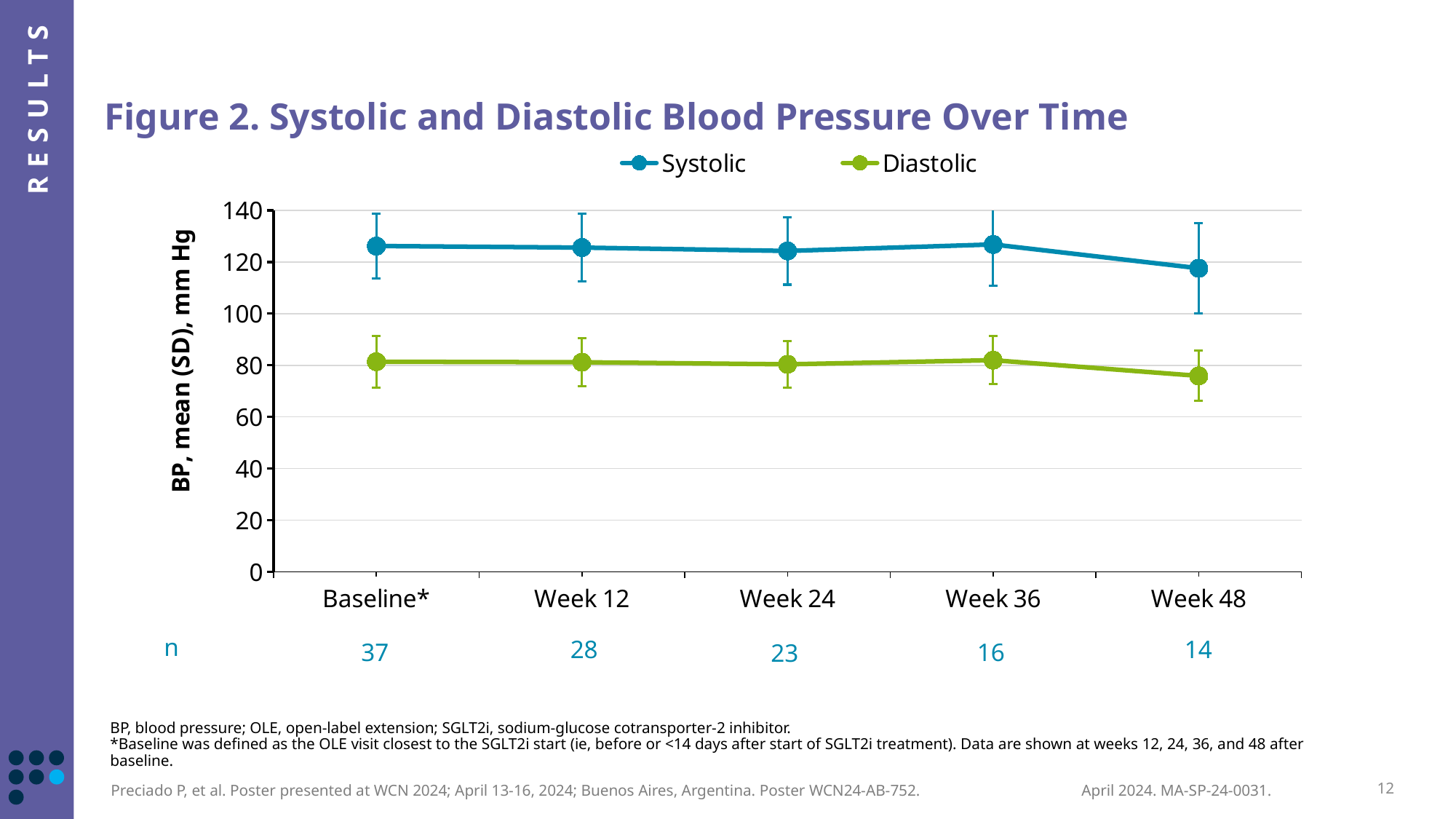
Which series has the higher value at Week 36, Systolic or Diastolic? Systolic What kind of chart is shown in Figure 2? Line chart Is the Diastolic value at Week 48 greater or less than 80? less Does the n value rise or fall from Baseline* to Week 48? Fall What is the n value shown for Week 48? 14 What is the n value shown for Week 24? 23 At which time point is the Systolic value lowest? Week 48 What is the n value shown for Baseline*? 37 How many time points are plotted along the x axis? 5 How many series does the legend list? 2 Is the Systolic value at Baseline* greater or less than 120? greater